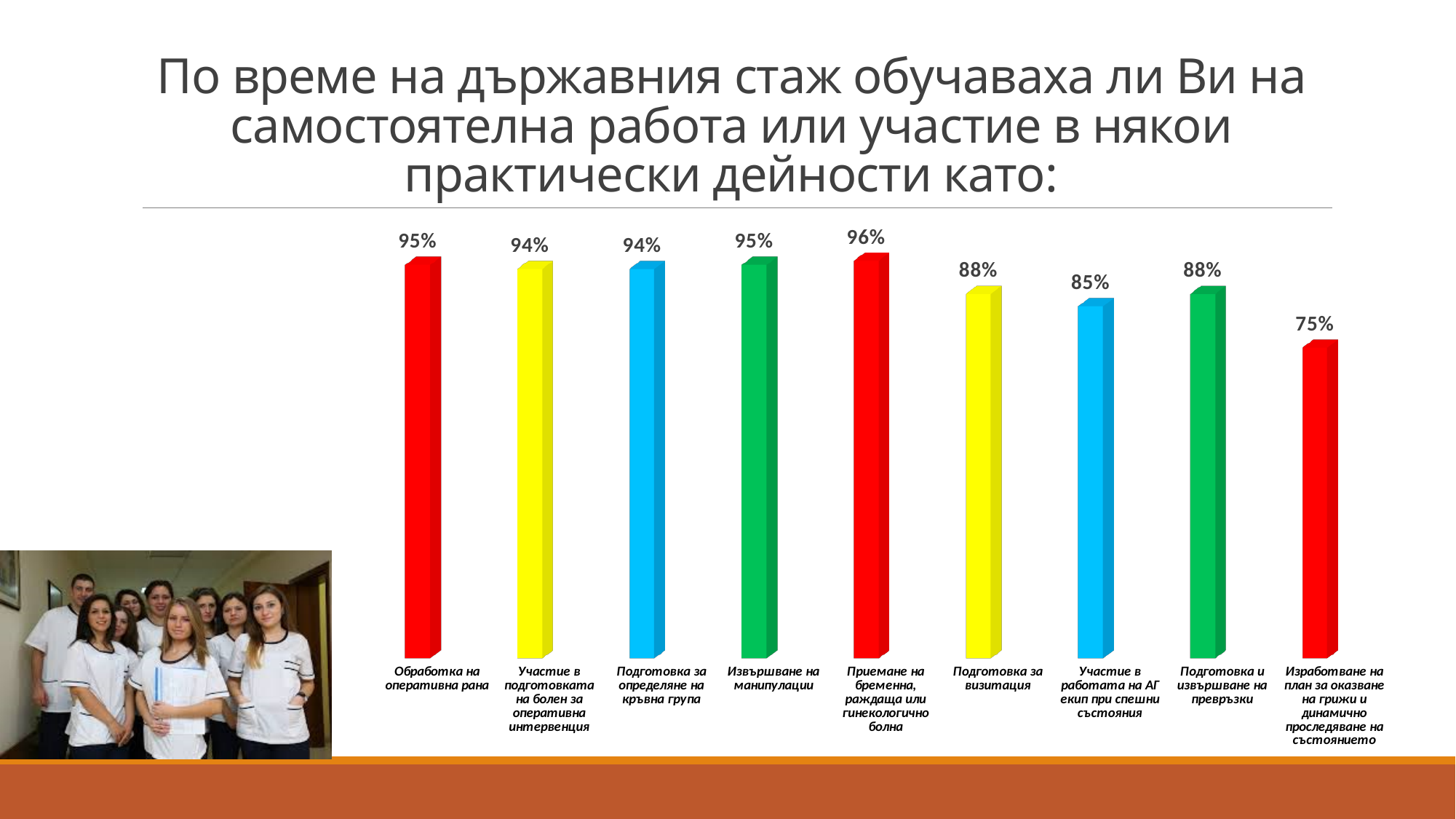
Which category has the lowest value? Изработване на план за оказване на грижи и динамично проследяване на състоянието What colour is the bar for "Извършване на манипулации"? Green What kind of chart is shown on the slide? Bar chart What is the difference between the values for "Извършване на манипулации" and "Подготовка и извършване на превръзки"? 7% What is the value for "Подготовка за визитация"? 88% Which is larger: the value for "Подготовка за визитация" or the value for "Участие в работата на АГ екип при спешни състояния"? Подготовка за визитация What is the value for "Подготовка за определяне на кръвна група"? 94% What is the value for "Участие в работата на АГ екип при спешни състояния"? 85% What is the value for "Обработка на оперативна рана"? 95% How many categories are shown in the chart? 9 Which category has the highest value? Приемане на бременна, раждаща или гинекологично болна What is the difference between the values for "Приемане на бременна, раждаща или гинекологично болна" and "Изработване на план за оказване на грижи и динамично проследяване на състоянието"? 21%